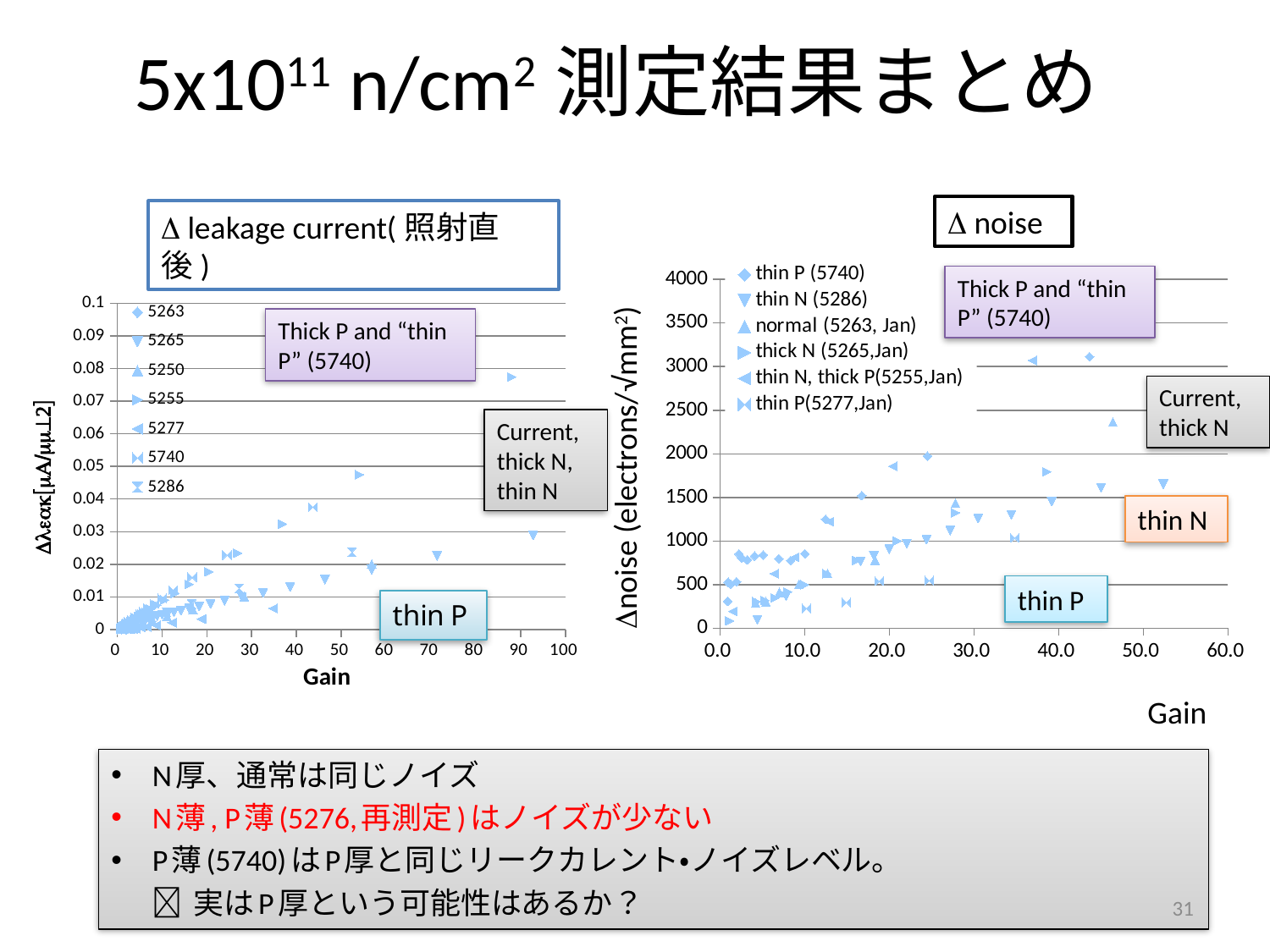
What is the y-axis title of the Δ noise chart? Δnoise (electrons/√mm²) In the Δ noise chart, is the highest plotted Δnoise value greater or less than 2500? greater What kind of chart is the Δ leakage current chart on the left? scatter chart In the Δ leakage current chart, is the highest plotted value greater or less than 0.05? greater What kind of chart is the Δ noise chart on the right? scatter chart In the Δ noise chart, do the Δnoise values generally rise or fall as Gain increases? rise In the Δ noise chart, what is the maximum value shown on the y axis? 4000 How many series does the legend of the Δ noise chart list? 6 What is the x-axis title of the Δ leakage current chart? Gain How many series does the legend of the Δ leakage current chart list? 7 In the Δ leakage current chart, do the values generally rise or fall as Gain increases? rise